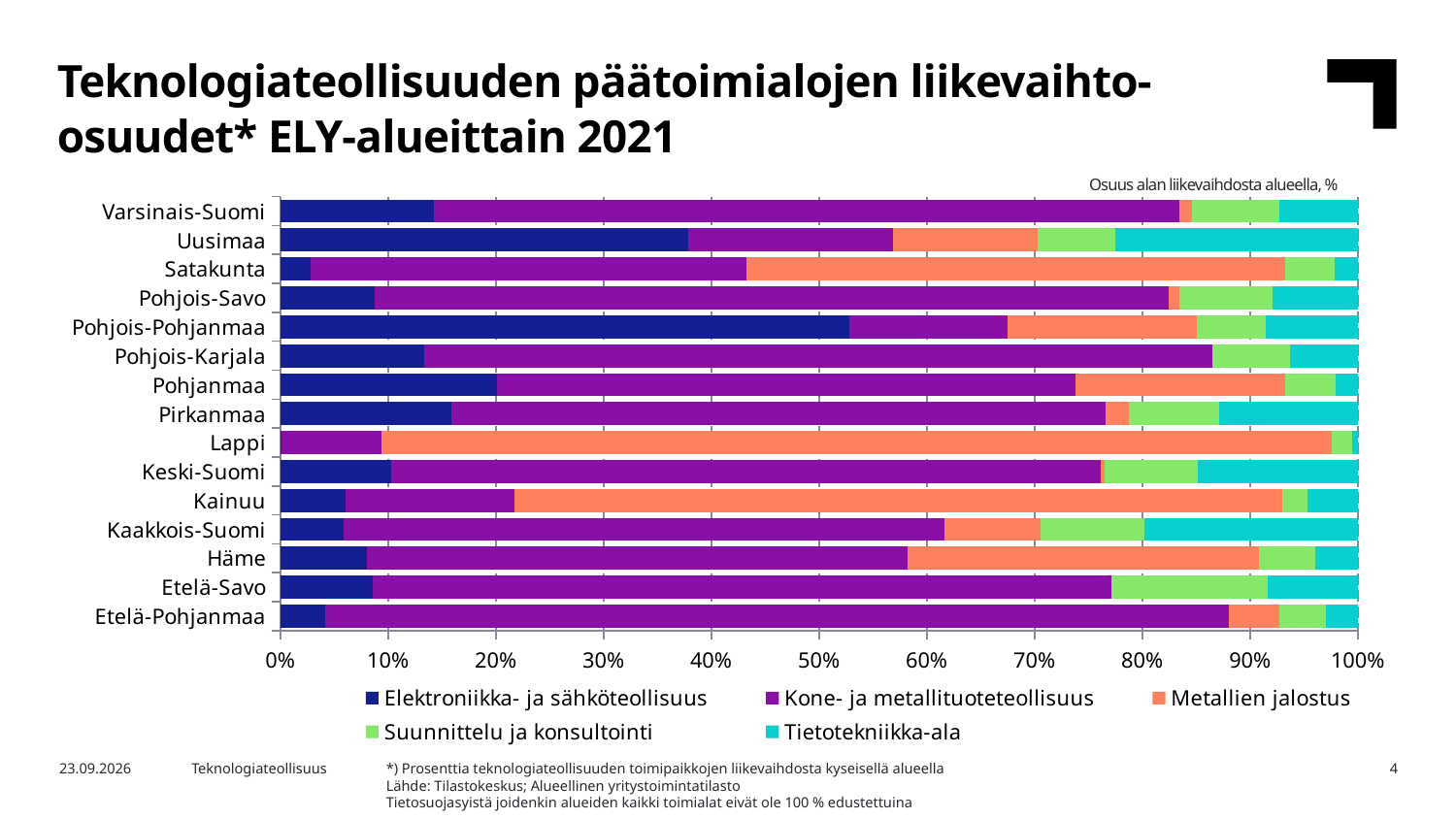
Is the Metallien jalostus share for Lappi greater or less than 80%? greater How many ELY regions are listed on the vertical axis of the chart? 15 Which series is listed first in the chart legend? Elektroniikka- ja sähköteollisuus Which region has the largest Metallien jalostus share? Lappi Which region has the largest Elektroniikka- ja sähköteollisuus share? Pohjois-Pohjanmaa Which region appears at the top of the chart? Varsinais-Suomi Which region has the largest Elektroniikka- ja sähköteollisuus share, Uusimaa or Satakunta? Uusimaa Is the Kone- ja metallituoteteollisuus share for Etelä-Pohjanmaa greater or less than 70%? greater How many series does the chart legend list? 5 What kind of chart is shown on the slide? Stacked bar chart Is the Elektroniikka- ja sähköteollisuus share for Uusimaa greater or less than 30%? greater